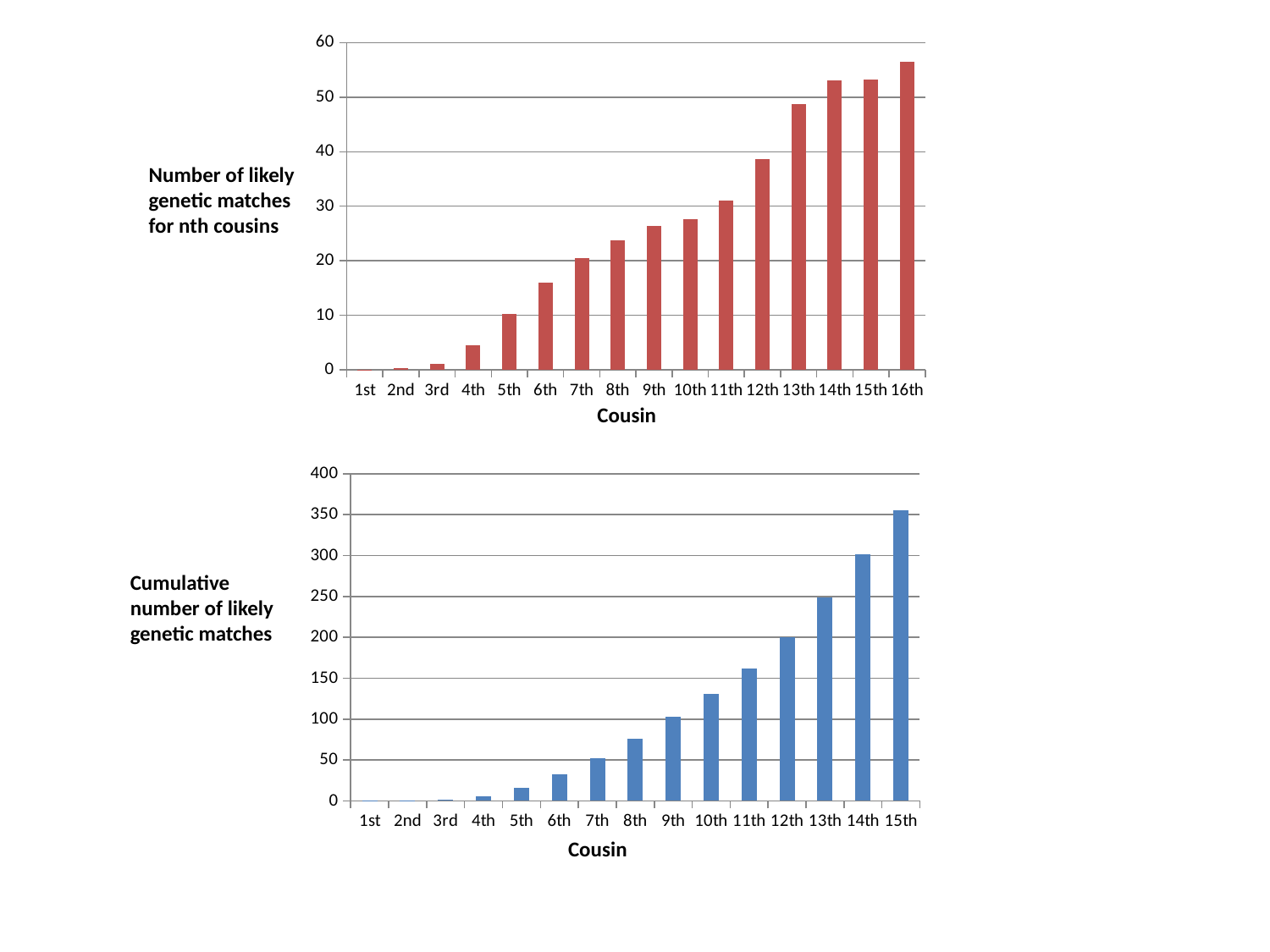
In the top chart, 'Number of likely genetic matches for nth cousins', is the value for 13th cousins greater or less than 50? less In the bottom chart, 'Cumulative number of likely genetic matches', do the values rise or fall as you move from 1st to 15th cousins along the x axis? rise In the bottom chart, 'Cumulative number of likely genetic matches', is the value for 6th cousins greater or less than 50? less In the bottom chart, 'Cumulative number of likely genetic matches', is the value for 11th cousins greater or less than 150? greater What is the x-axis label of the bottom chart, 'Cumulative number of likely genetic matches'? Cousin How many cousin categories are shown on the x axis of the bottom chart, 'Cumulative number of likely genetic matches'? 15 How many cousin categories are shown on the x axis of the top chart, 'Number of likely genetic matches for nth cousins'? 16 What kind of chart is the top chart, 'Number of likely genetic matches for nth cousins'? bar chart In the top chart, 'Number of likely genetic matches for nth cousins', which is larger: the value for 11th cousins or 12th cousins? 12th In the bottom chart, 'Cumulative number of likely genetic matches', which cousin category has the highest value? 15th In the top chart, 'Number of likely genetic matches for nth cousins', which cousin category has the highest value? 16th